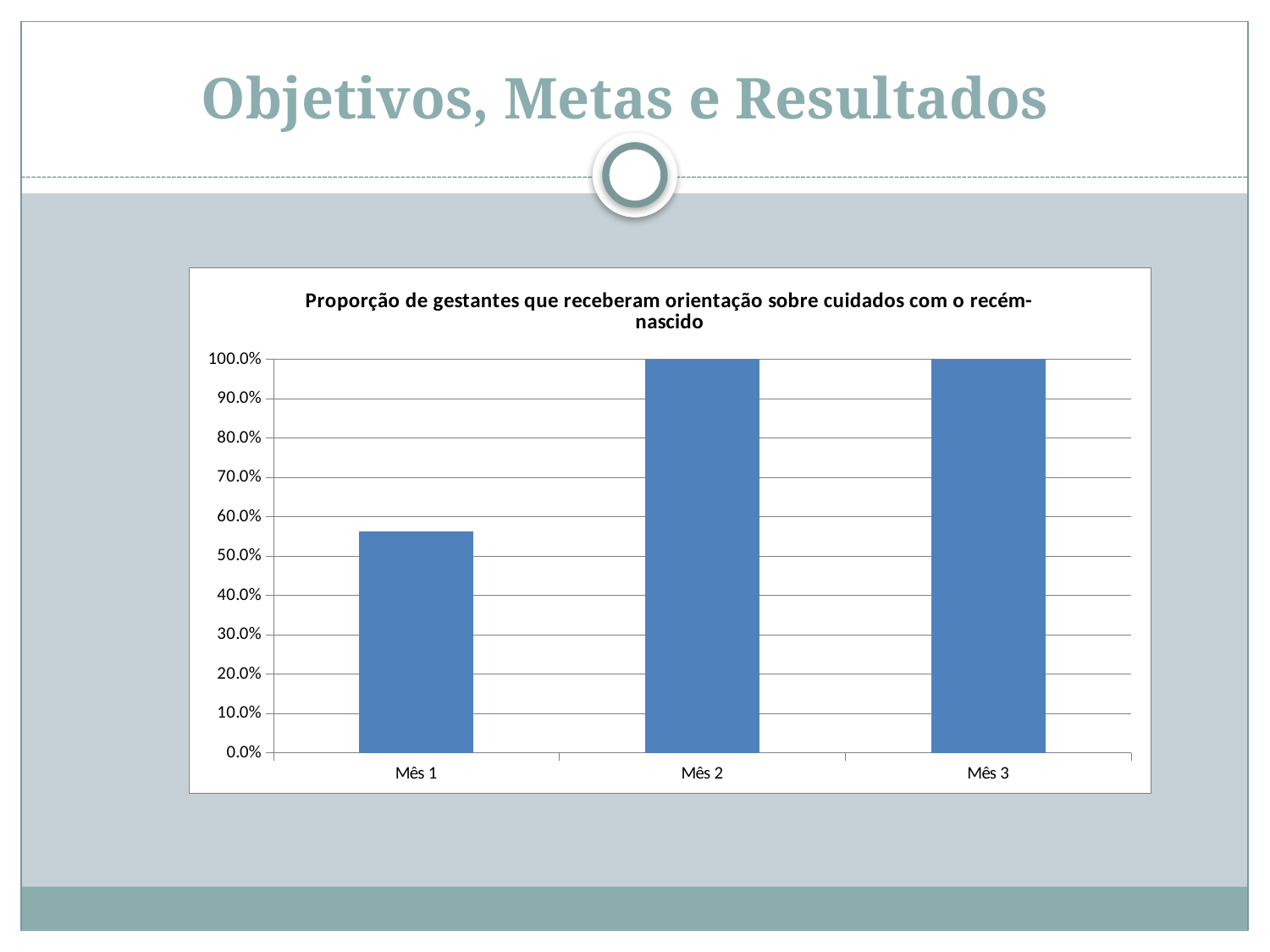
How many categories are shown on the x axis of the chart? 3 Which is larger, the value for Mês 3 or the value for Mês 1? Mês 3 What is the value for Mês 2? 100.0% What kind of chart is shown on the slide? bar chart Which category has the lowest value in the chart? Mês 1 Does the value rise or fall from Mês 1 to Mês 2? rise What is the title of the chart? Proporção de gestantes que receberam orientação sobre cuidados com o recém-nascido Which is larger, the value for Mês 1 or the value for Mês 2? Mês 2 Is the value for Mês 1 greater or less than 60.0%? less Is the value for Mês 1 greater or less than 50.0%? greater What is the highest value shown on the y axis of the chart? 100.0% What is the value for Mês 3? 100.0%